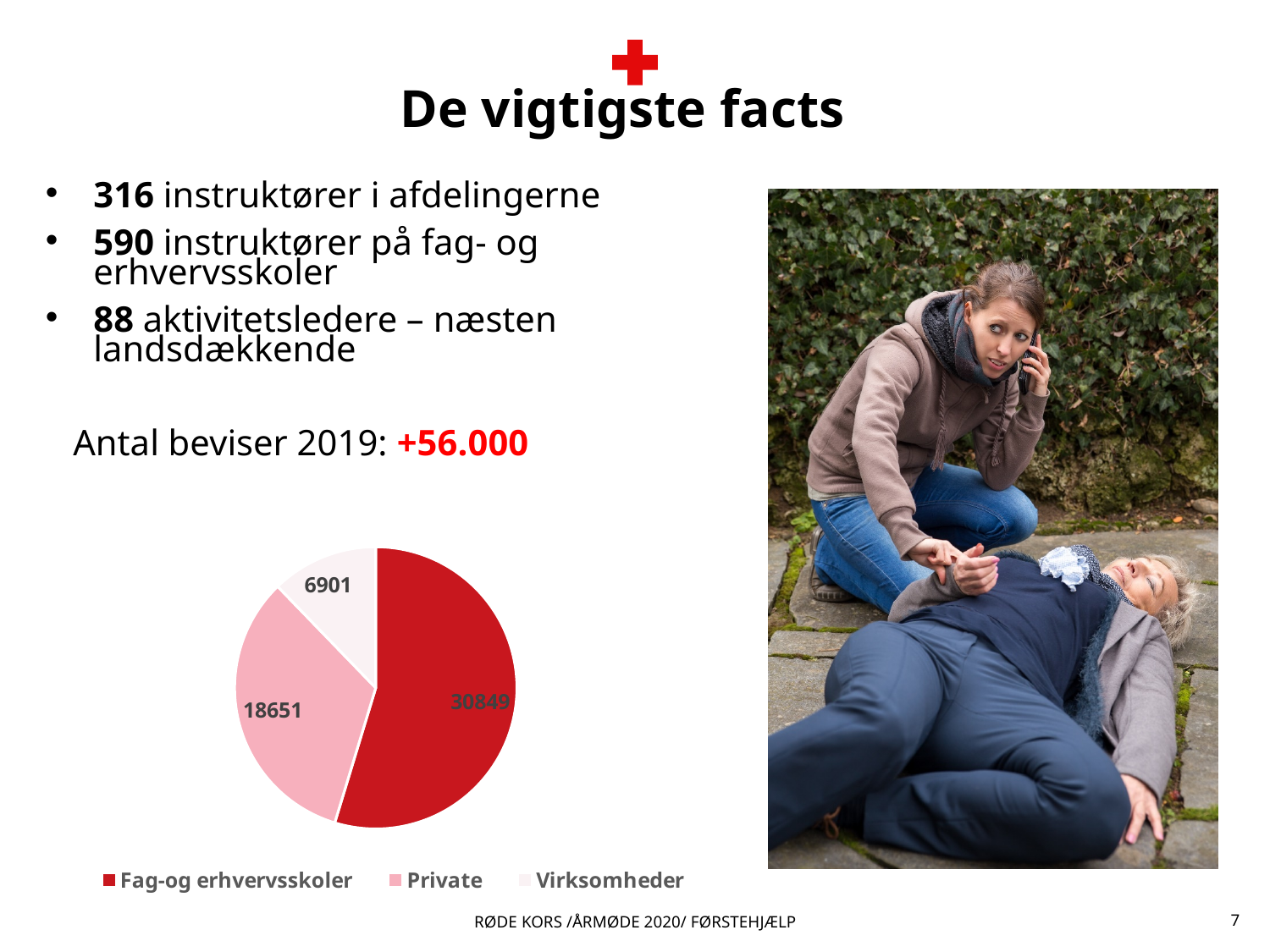
What type of chart is shown on the slide? Pie chart What colour is the Fag-og erhvervsskoler slice in the pie chart? Dark red What is the difference between the Private value and the Virksomheder value in the pie chart? 11750 Which is larger in the pie chart, Private or Virksomheder? Private What is the total of all three slices in the pie chart? 56401 What value is shown for the Fag-og erhvervsskoler slice of the pie chart? 30849 Which category has the largest slice in the pie chart? Fag-og erhvervsskoler What value is shown for the Private slice of the pie chart? 18651 Which category has the smallest slice in the pie chart? Virksomheder What value is shown for the Virksomheder slice of the pie chart? 6901 How many slices does the pie chart have? 3 What is the difference between the Fag-og erhvervsskoler value and the Private value in the pie chart? 12198